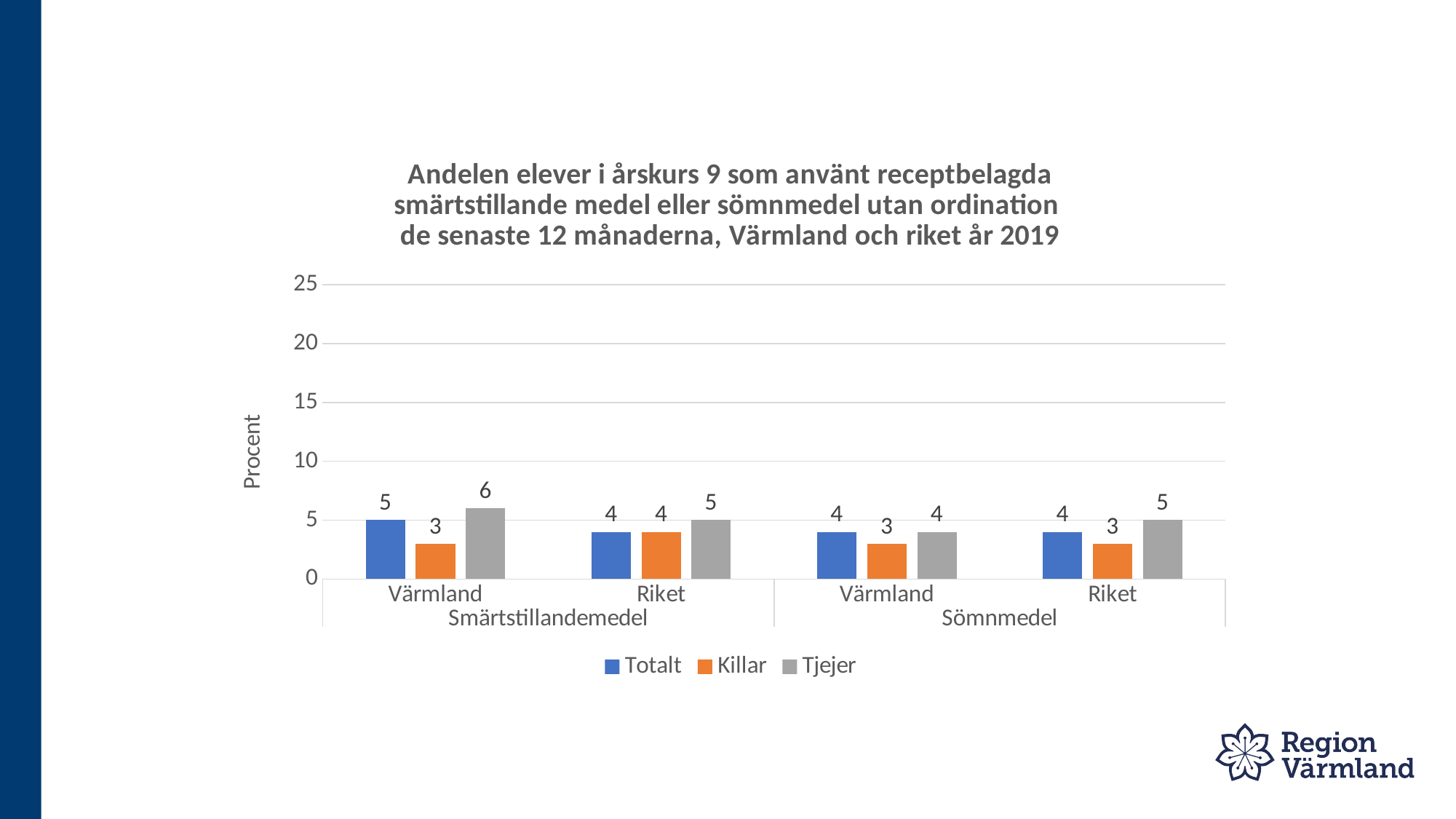
What is the difference between the Tjejer and Killar values in Värmland under Smärtstillandemedel? 3 How many series does the legend list? 3 What is the label on the vertical axis? Procent Is the value for Tjejer in Värmland under Smärtstillandemedel greater or less than 10? less Which series has the highest value in Värmland under Smärtstillandemedel? Tjejer Which series has the lowest value in Riket under Sömnmedel? Killar Which is larger: the Tjejer value for Värmland or for Riket under Smärtstillandemedel? Värmland What is the value for Tjejer in Riket under Sömnmedel? 5 What kind of chart is shown on the slide? Bar chart What is the value for Tjejer in Värmland under Smärtstillandemedel? 6 What is the value for Totalt in Riket under Sömnmedel? 4 What is the value for Killar in Värmland under Smärtstillandemedel? 3